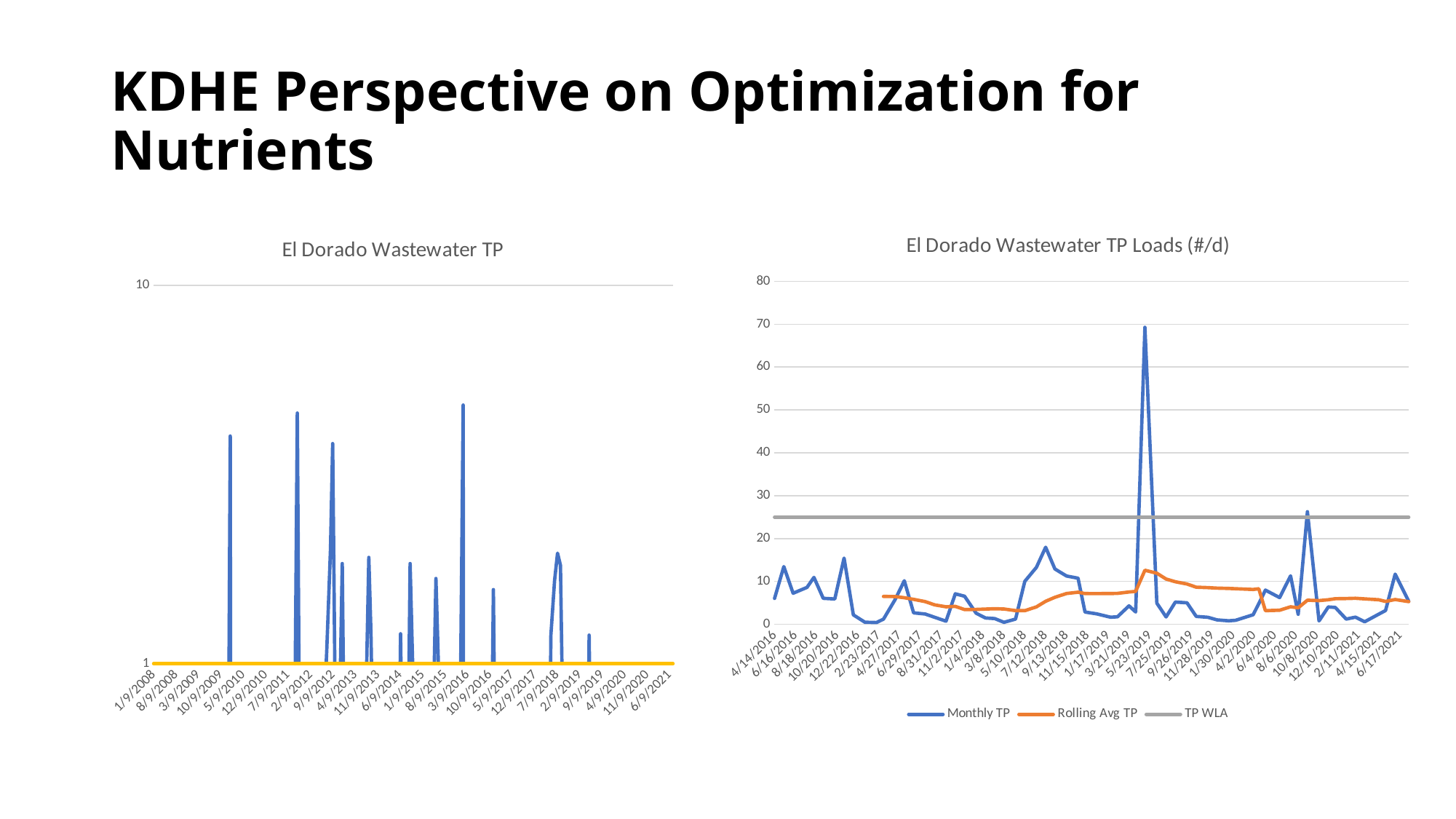
In the 'El Dorado Wastewater TP Loads (#/d)' chart, is the peak value of Monthly TP near 5/23/2019 greater or less than 60? greater What kind of chart is the 'El Dorado Wastewater TP' chart on the left? line chart How many series does the legend of the 'El Dorado Wastewater TP Loads (#/d)' chart list? 3 In the 'El Dorado Wastewater TP Loads (#/d)' chart, which is larger at the 5/23/2019 peak: Monthly TP or TP WLA? Monthly TP In the 'El Dorado Wastewater TP' chart on the left, is the peak value near 3/9/2016 greater or less than 10? less What kind of chart is the 'El Dorado Wastewater TP Loads (#/d)' chart on the right? line chart In the 'El Dorado Wastewater TP Loads (#/d)' chart, is the TP WLA line greater or less than 30? less In the 'El Dorado Wastewater TP Loads (#/d)' chart, around which x-axis date does the Monthly TP series reach its highest value? 5/23/2019 What is the highest value shown on the y axis of the 'El Dorado Wastewater TP Loads (#/d)' chart? 80 In the 'El Dorado Wastewater TP Loads (#/d)' chart, which series is drawn in orange? Rolling Avg TP